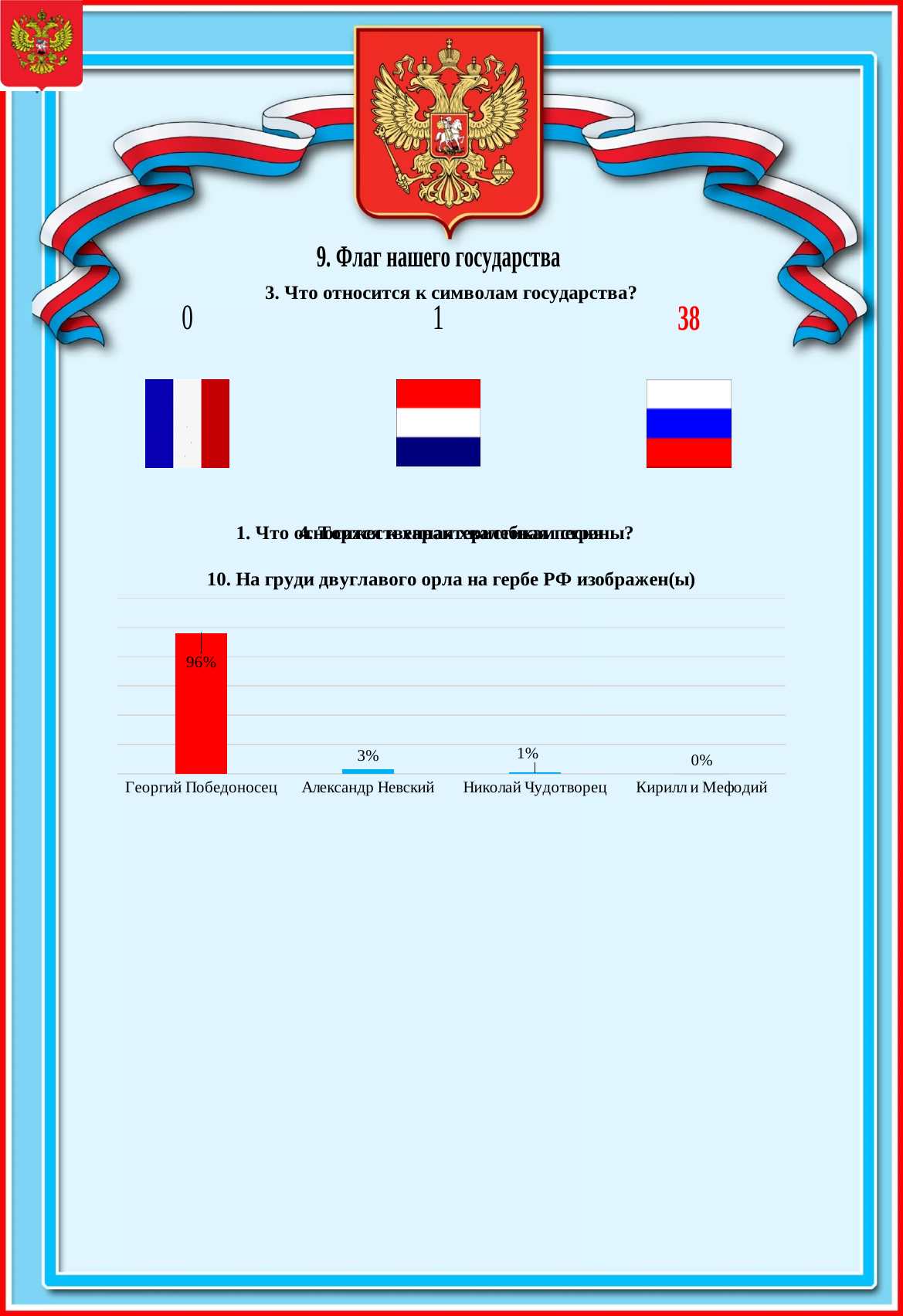
In the chart titled "10. На груди двуглавого орла на гербе РФ изображен(ы)", which category has the lowest value? Кирилл и Мефодий In the chart titled "10. На груди двуглавого орла на гербе РФ изображен(ы)", what is the difference between the values for Георгий Победоносец and Александр Невский? 93% In the chart titled "10. На груди двуглавого орла на гербе РФ изображен(ы)", what colour is the bar for Георгий Победоносец? Red How many categories are shown in the chart titled "10. На груди двуглавого орла на гербе РФ изображен(ы)"? 4 In the chart titled "10. На груди двуглавого орла на гербе РФ изображен(ы)", which category has the highest value? Георгий Победоносец In the chart titled "10. На груди двуглавого орла на гербе РФ изображен(ы)", what is the difference between the values for Александр Невский and Николай Чудотворец? 2% In the chart titled "10. На груди двуглавого орла на гербе РФ изображен(ы)", what is the value for Александр Невский? 3% In the chart titled "10. На груди двуглавого орла на гербе РФ изображен(ы)", what is the value for Георгий Победоносец? 96% In the chart titled "10. На груди двуглавого орла на гербе РФ изображен(ы)", what is the value for Николай Чудотворец? 1% What kind of chart is the one titled "10. На груди двуглавого орла на гербе РФ изображен(ы)"? Bar chart In the chart titled "10. На груди двуглавого орла на гербе РФ изображен(ы)", which is larger: the value for Александр Невский or the value for Николай Чудотворец? Александр Невский In the chart titled "10. На груди двуглавого орла на гербе РФ изображен(ы)", what is the value for Кирилл и Мефодий? 0%